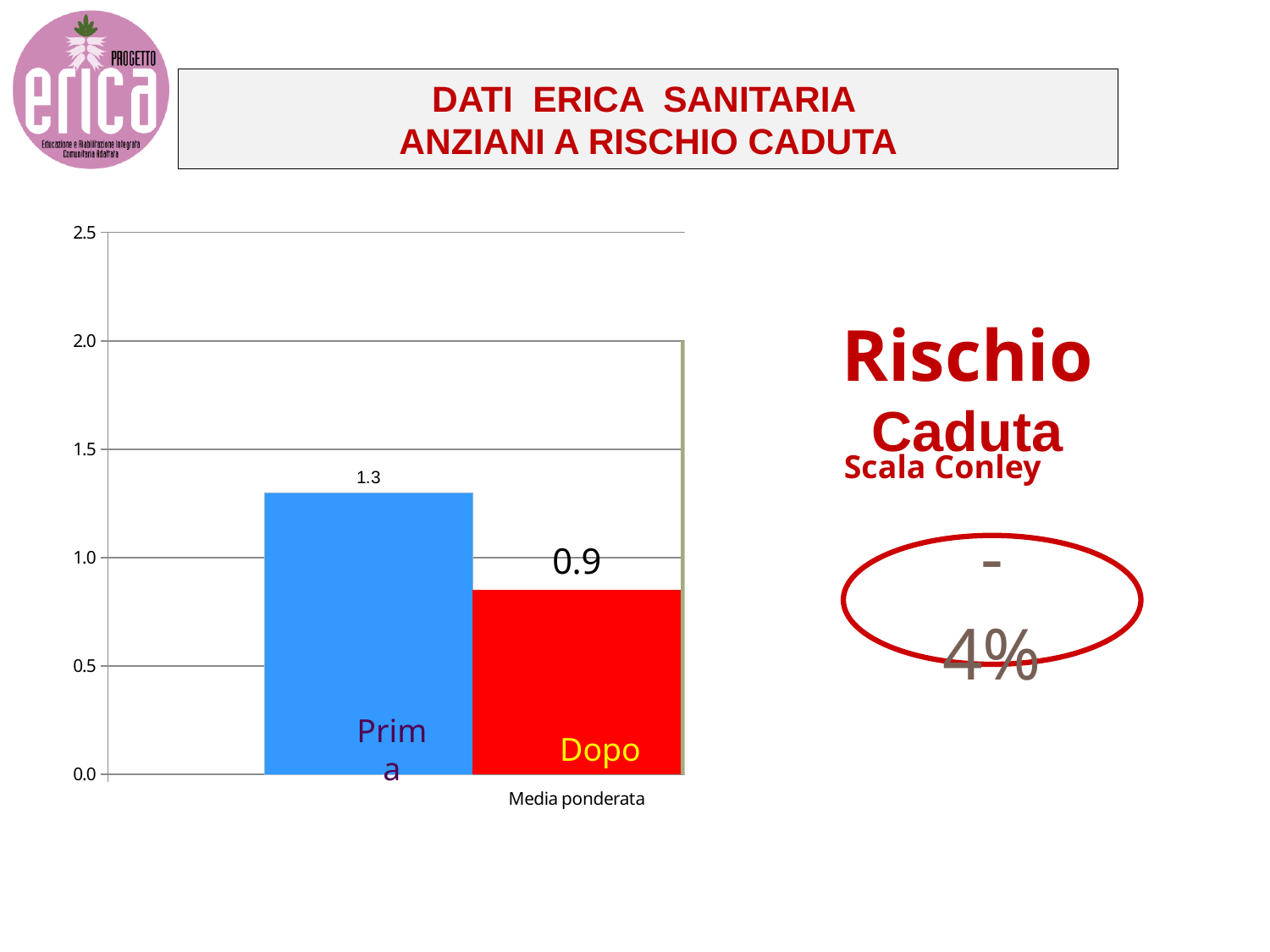
What is the label shown below the x axis of the chart? Media ponderata Is the value for Dopo greater or less than 1.0? less Is the value for Prima greater or less than 1.0? greater What is the difference between the Prima and Dopo values? 0.4 Which bar has the lowest value? Dopo What colour is the Dopo bar? red Do the values fall or rise from Prima to Dopo? fall What is the value of the Prima bar? 1.3 What is the value of the Dopo bar? 0.9 Which bar is higher, Prima or Dopo? Prima What kind of chart is shown on the slide? bar chart